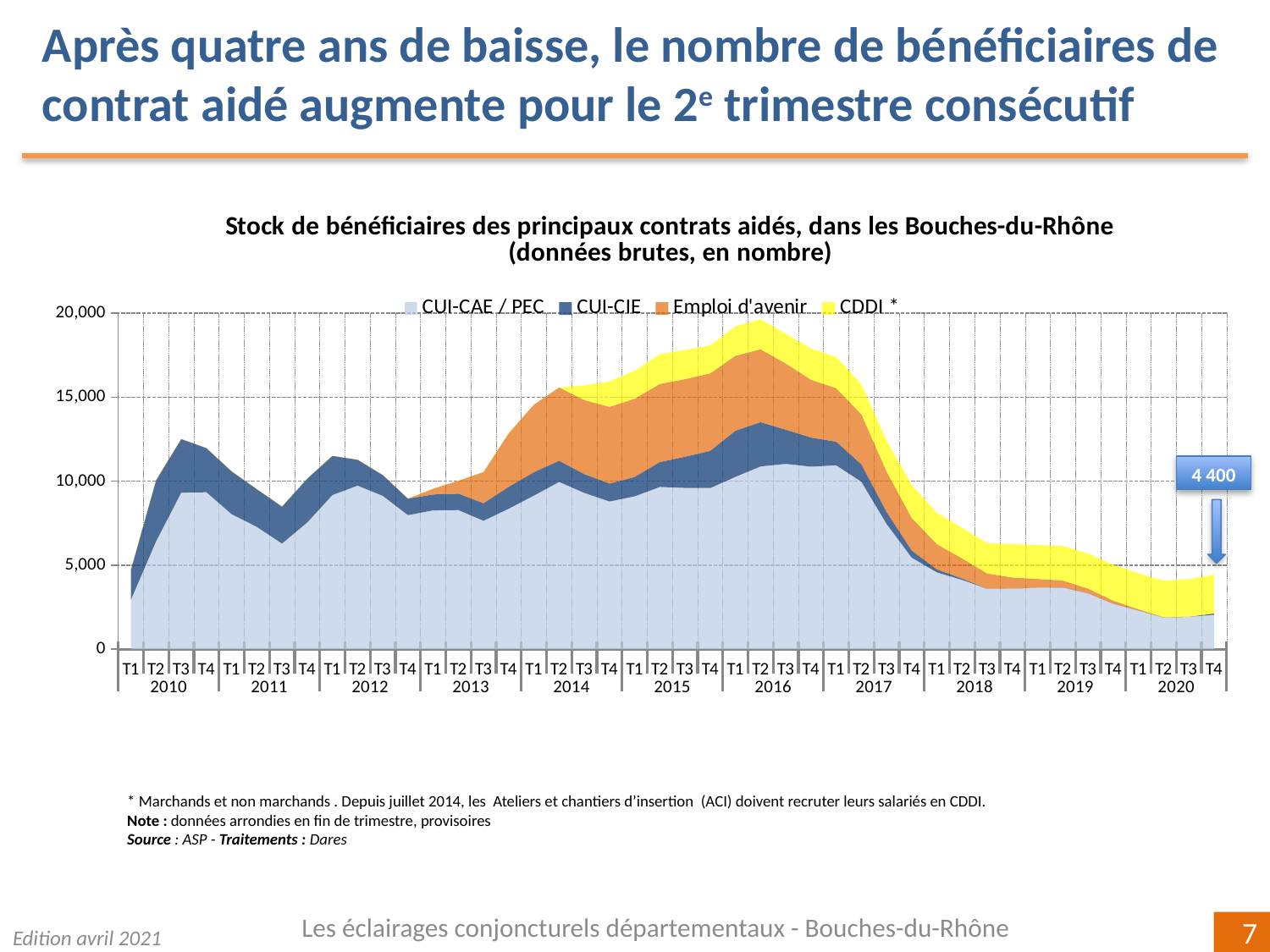
What total value is labelled on the chart for T4 2020? 4 400 Which series are listed in the chart legend? CUI-CAE / PEC, CUI-CIE, Emploi d'avenir, CDDI * Is the total stock of beneficiaries in T1 2010 greater or less than 5,000? less Is the total stock of beneficiaries in T4 2018 greater or less than 10,000? less How many series does the chart legend list? 4 What kind of chart is shown on the slide? Area chart How many years are shown along the x axis of the chart? 11 Is the total stock of beneficiaries in T2 2016 greater or less than 15,000? greater Does the total stock of beneficiaries rise or fall between T1 2017 and T2 2020? fall What is the title of the chart? Stock de bénéficiaires des principaux contrats aidés, dans les Bouches-du-Rhône (données brutes, en nombre) In which year does the total stock of beneficiaries reach its highest level? 2016 Which is larger, the total stock of beneficiaries in T2 2016 or in T2 2019? T2 2016